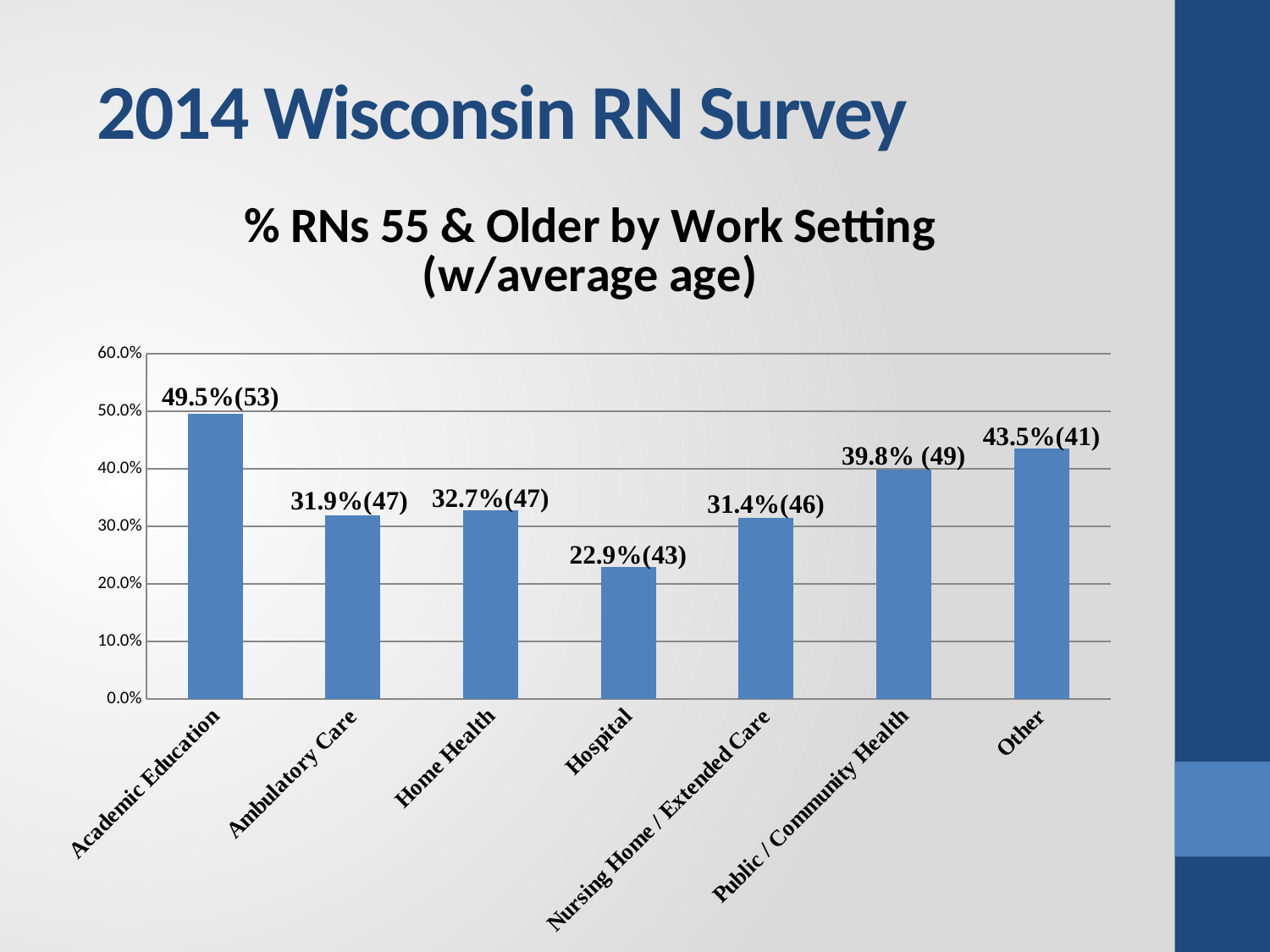
What is the difference in percentage points between Academic Education and Hospital? 26.6 Which work setting has the lowest percentage of RNs 55 and older? Hospital What is the title of the chart? % RNs 55 & Older by Work Setting (w/average age) What is the average age shown for the Other work setting? 41 What kind of chart is shown on the slide? Bar chart Which work setting has the highest percentage of RNs 55 and older? Academic Education What is the average age shown for Public / Community Health? 49 How many work settings are shown on the chart? 7 Is the value for Nursing Home / Extended Care greater or less than 40.0%? less What percentage of RNs in Academic Education are 55 and older? 49.5% What percentage of RNs in Hospital settings are 55 and older? 22.9% Which has a higher percentage of RNs 55 and older, Home Health or Ambulatory Care? Home Health